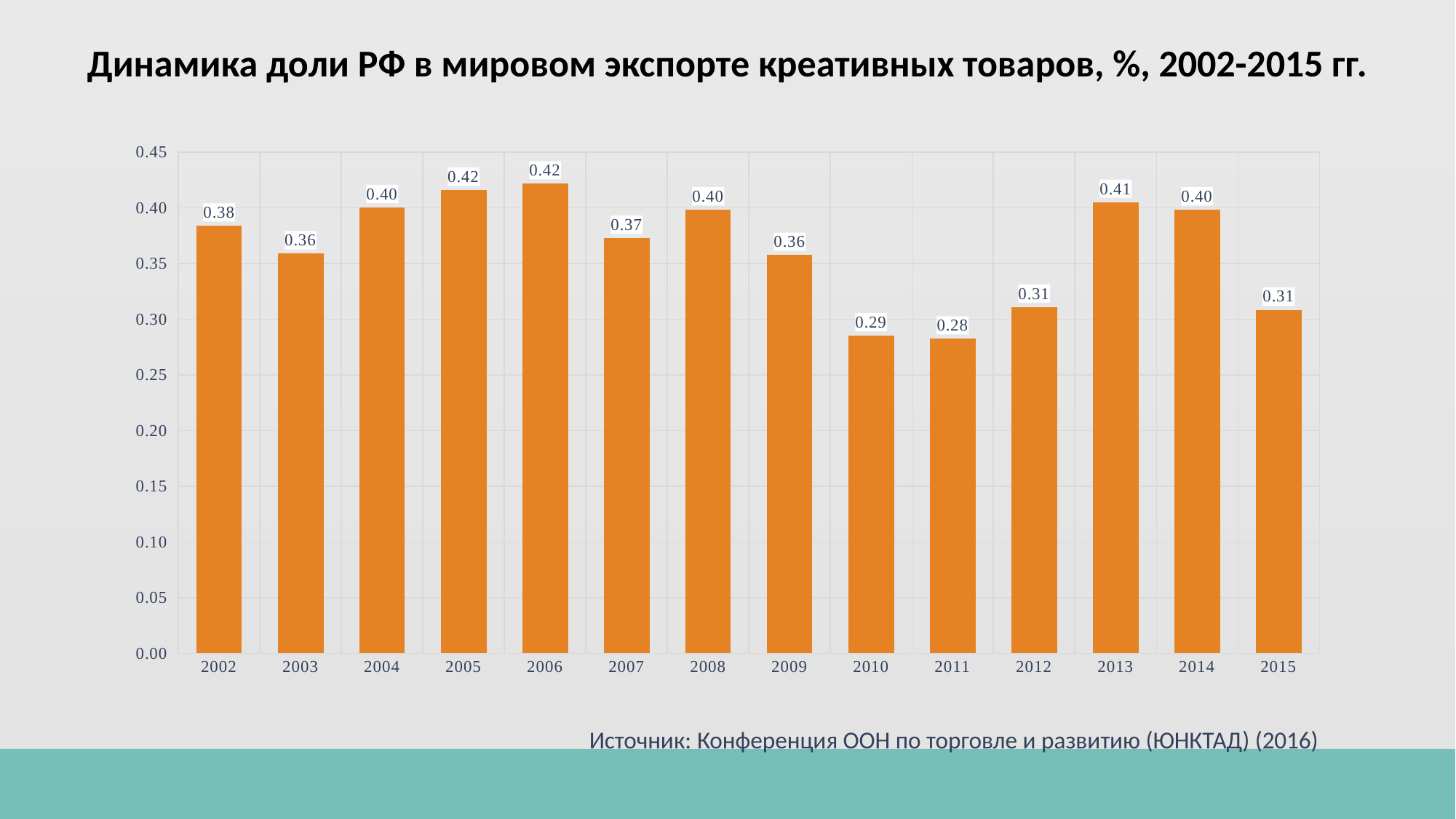
Which year has the lowest value? 2011 What is the value for 2011? 0.28 What is the difference between the values for 2006 and 2011? 0.14 What is the value for 2013? 0.41 Is the value for 2010 greater or less than 0.30? less Which is larger, the value for 2004 or the value for 2009? 2004 Do the values rise or fall from 2006 to 2011? fall What is the value for 2015? 0.31 What is the value for 2002? 0.38 How many years are shown on the x axis? 14 What kind of chart is shown on the slide? bar chart What is the difference between the values for 2013 and 2015? 0.10